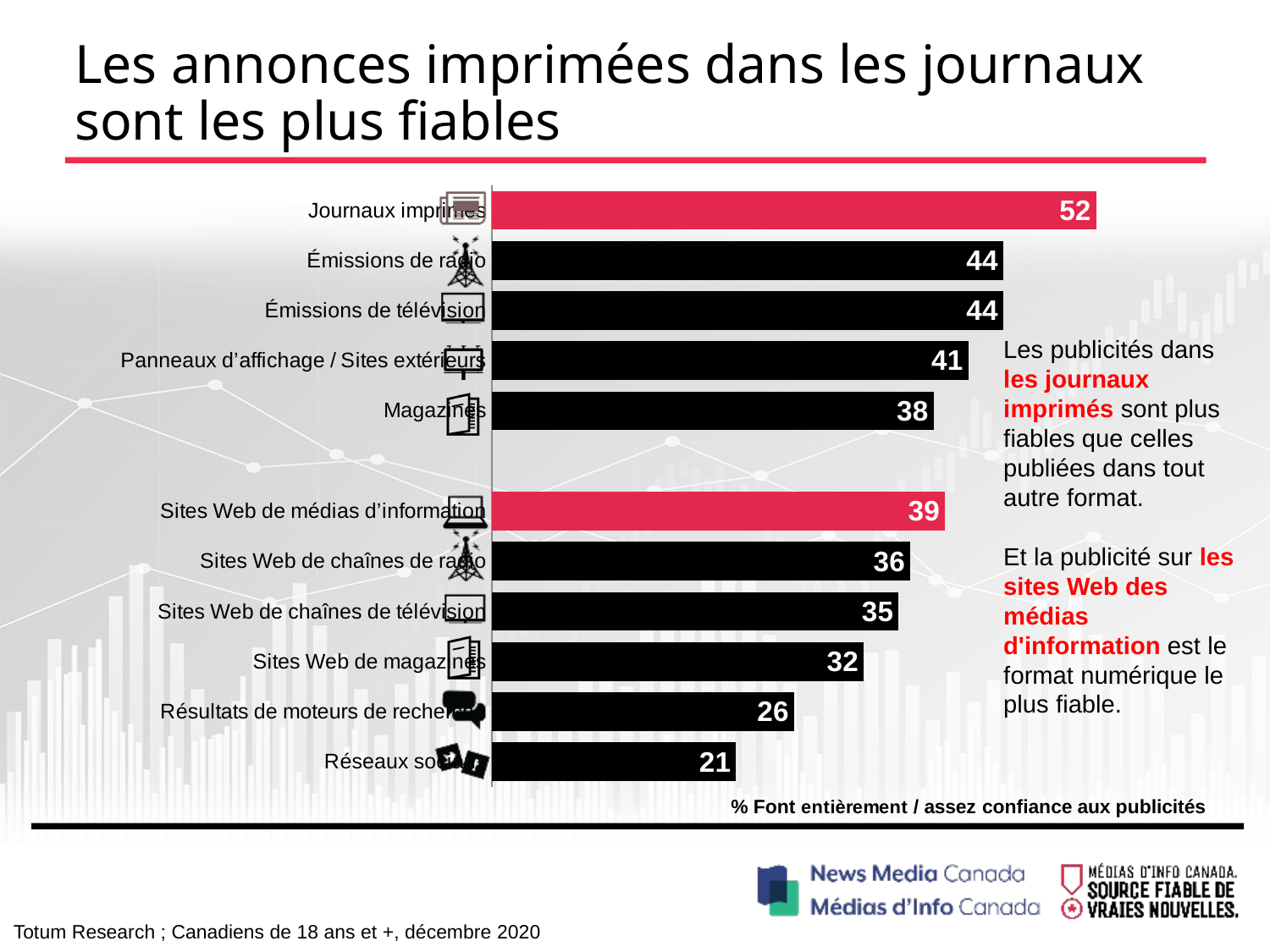
How many categories are shown in the chart? 11 What value is shown for Réseaux sociaux? 21 What is the difference between the values for Sites Web de médias d'information and Sites Web de chaînes de radio? 3 Which is larger, the value for Magazines or the value for Sites Web de magazines? Magazines What value is shown for Panneaux d'affichage / Sites extérieurs? 41 What value is shown for Sites Web de médias d'information? 39 What kind of chart is shown on the slide? Bar chart What value is shown for Journaux imprimés? 52 What is the difference between the values for Journaux imprimés and Réseaux sociaux? 31 Which category has the highest value? Journaux imprimés Which two categories are highlighted with red bars? Journaux imprimés and Sites Web de médias d'information Which category has the lowest value? Réseaux sociaux